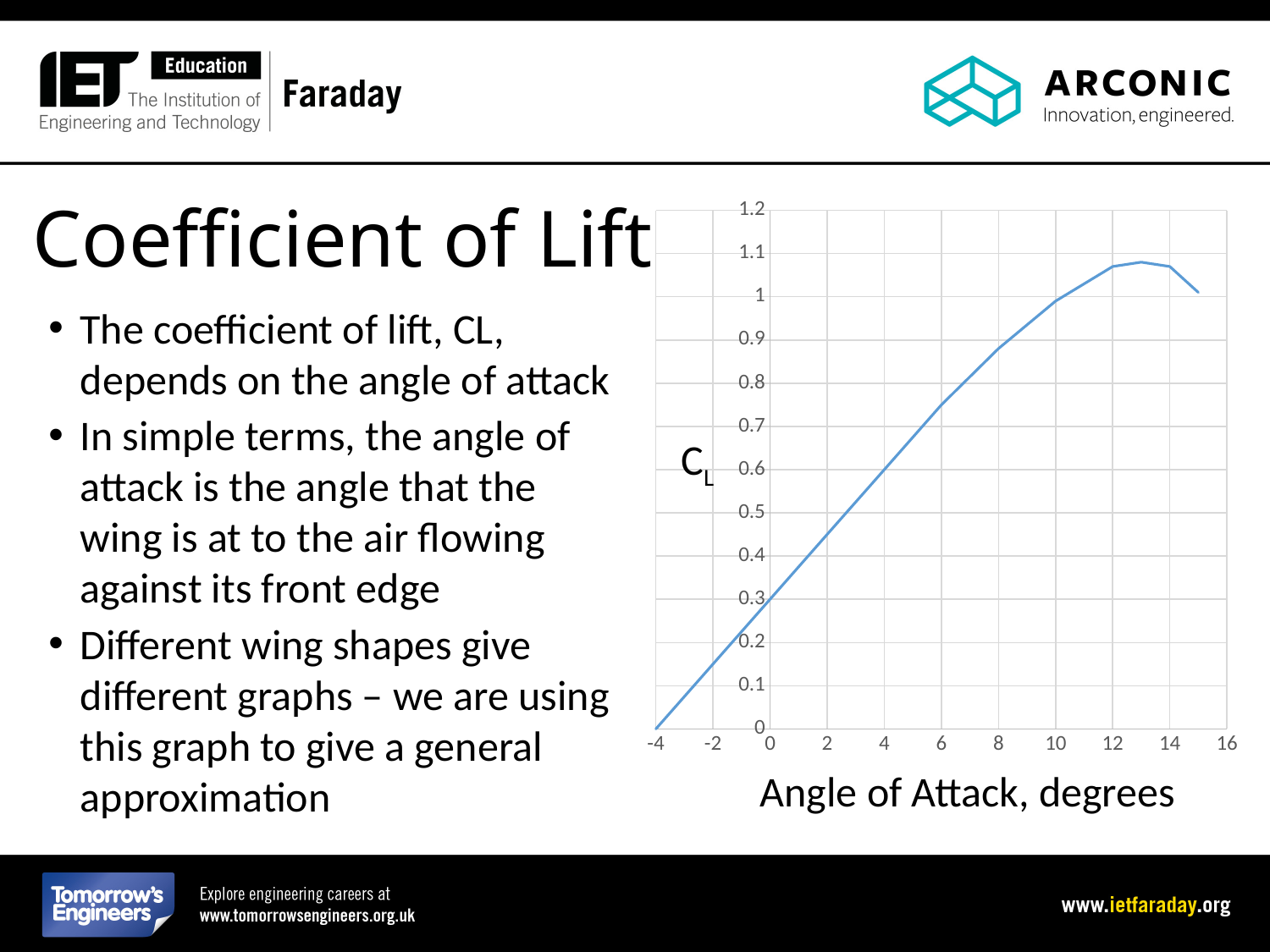
Does CL rise or fall as the angle of attack increases from -4 to 10 degrees? rise Is the value of CL at an angle of attack of 12 degrees greater or less than 1? greater Is CL larger at an angle of attack of 6 degrees or at 2 degrees? 6 degrees Is the value of CL at an angle of attack of 4 degrees greater or less than 0.5? greater Is the value of CL at an angle of attack of 0 degrees greater or less than 0.2? greater What is the label of the y axis of the chart? CL What kind of chart is shown on the slide? line chart What is the value of CL at an angle of attack of -4 degrees? 0 What is the label of the x axis of the chart? Angle of Attack, degrees Does CL rise or fall as the angle of attack increases from 14 to 15 degrees? fall